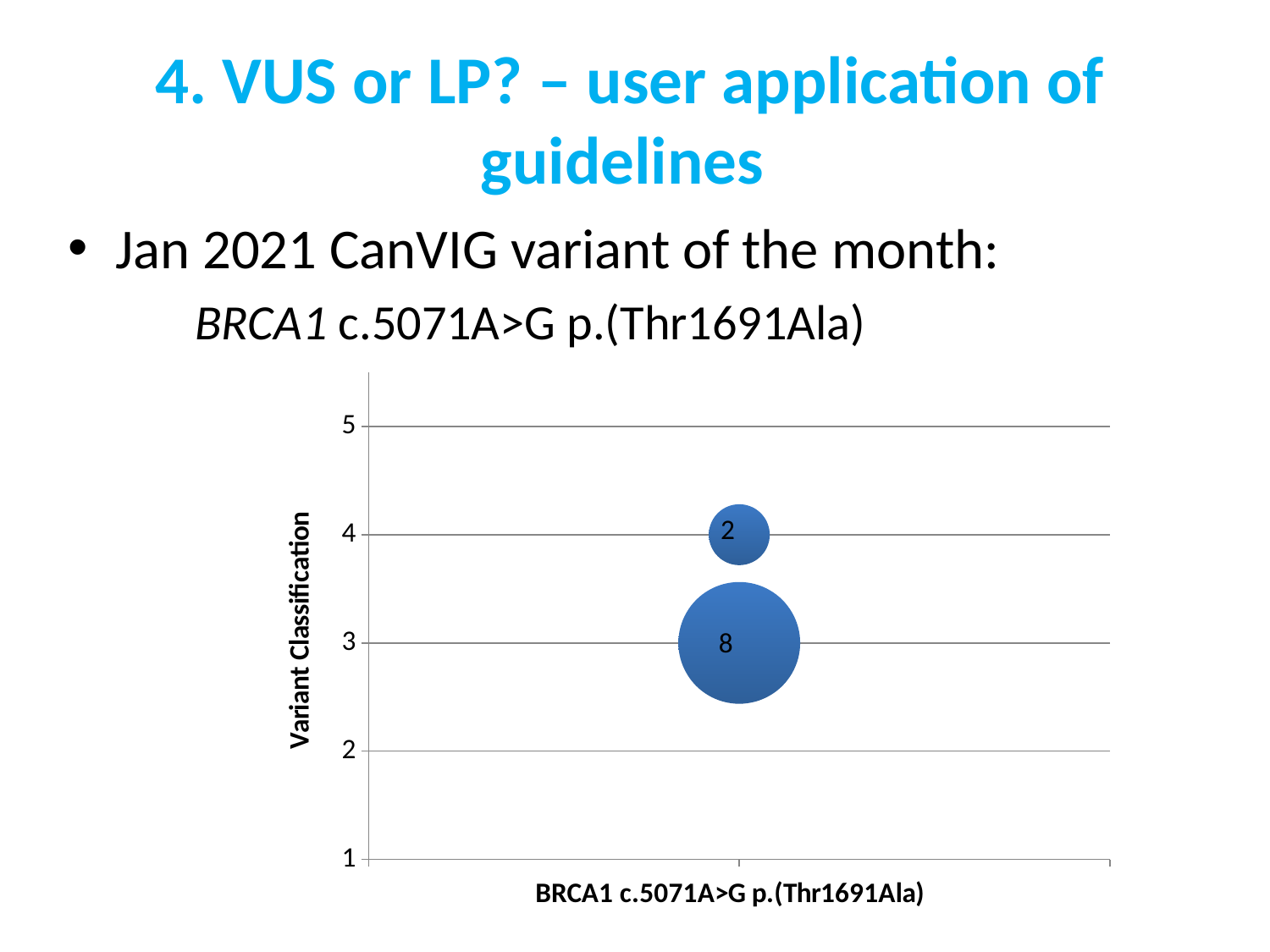
Which variant classification has the larger bubble, 3 or 4? 3 Is the bubble value at classification 3 larger or smaller than the bubble value at classification 4? larger Which variant classification has the smaller bubble, 3 or 4? 4 How many bubbles are plotted on the chart? 2 What is the total of the two bubble values shown on the chart? 10 What kind of chart is shown on the slide? bubble chart What is the difference between the bubble values at classification 3 and classification 4? 6 What is the title of the vertical axis? Variant Classification What value is labelled on the bubble at variant classification 3? 8 What label appears on the horizontal axis of the chart? BRCA1 c.5071A>G p.(Thr1691Ala) What is the highest tick value shown on the vertical axis? 5 What value is labelled on the bubble at variant classification 4? 2